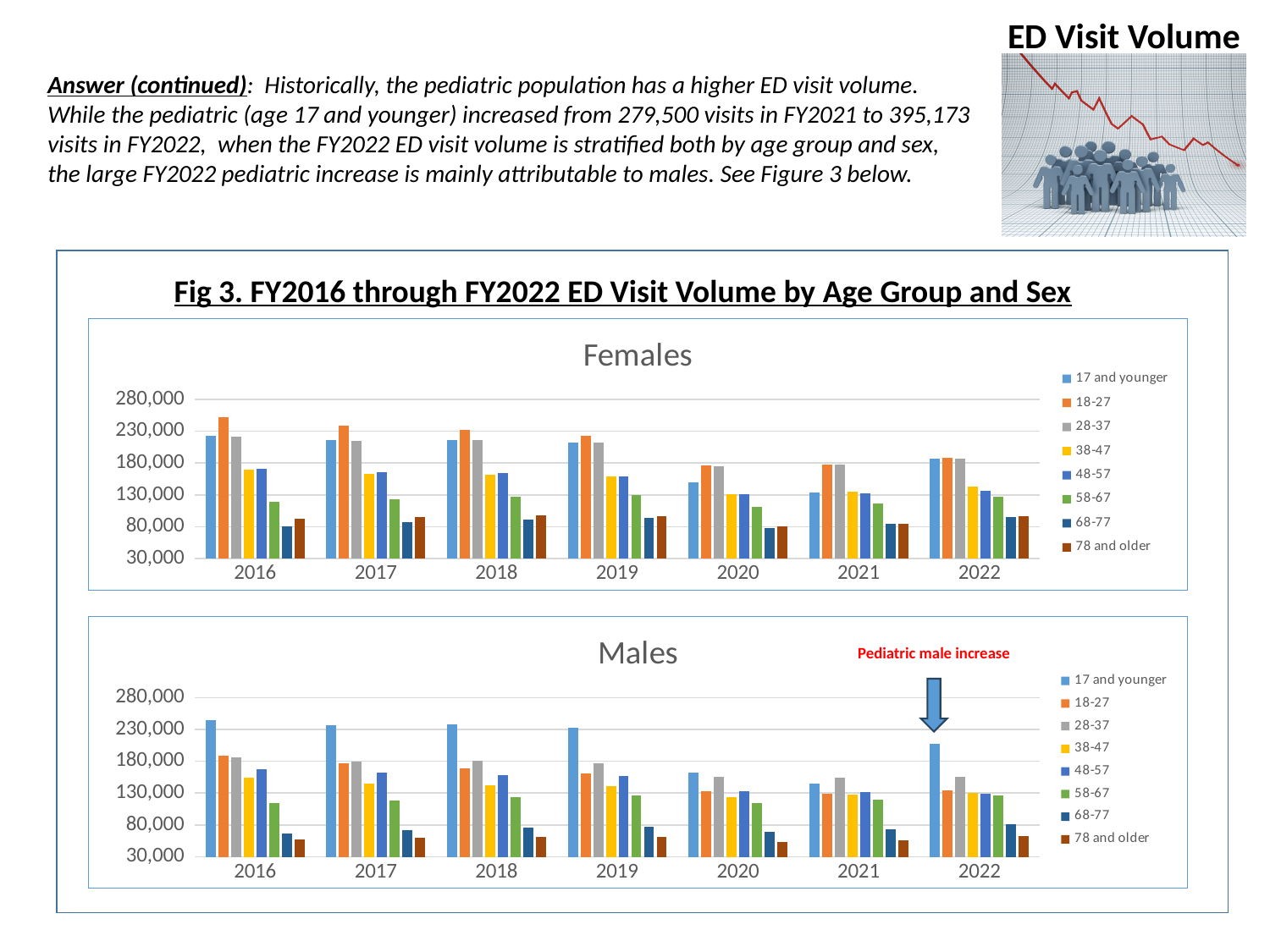
In the Males chart, which age group has the lowest value in 2022? 78 and older In the Males chart, which is larger in 2016: 17 and younger or 18-27? 17 and younger What kind of chart is the Females chart? bar chart In the Females chart, which age group has the highest value in 2016? 18-27 In the Females chart, which age group has the lowest value in 2016? 68-77 In the Males chart, is the value for 78 and older in 2016 greater or less than 80,000? less In the Males chart, is the value for 17 and younger in 2022 greater or less than 180,000? greater How many years are shown on the x axis of the Females chart? 7 In the Males chart, does the 17 and younger series rise or fall from 2016 to 2021? fall What is the title of the figure containing the two charts? Fig 3. FY2016 through FY2022 ED Visit Volume by Age Group and Sex How many series does the legend of the Males chart list? 8 In the Males chart, which age group has the highest value in 2022? 17 and younger